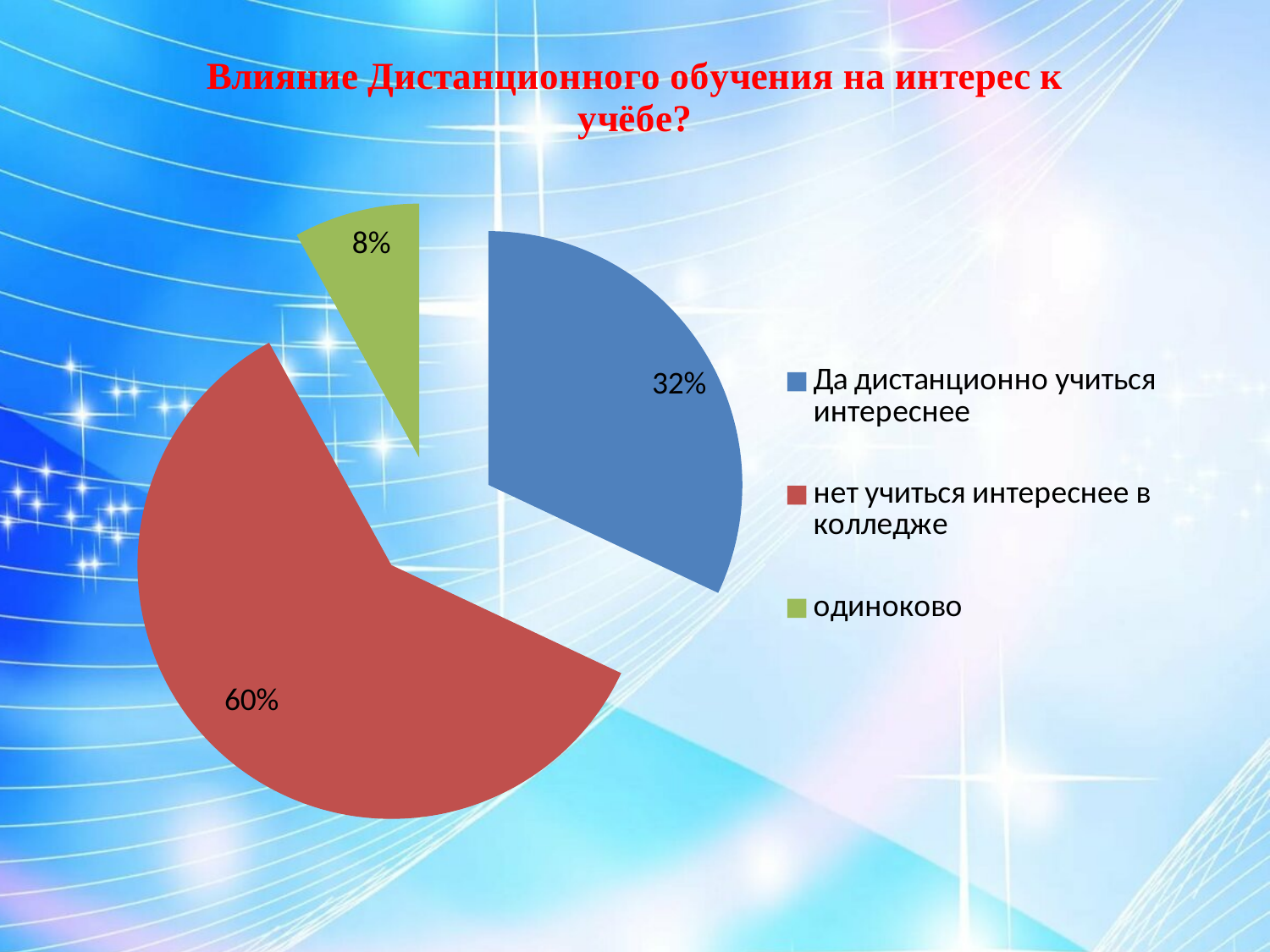
How many entries does the legend list? 3 What kind of chart is shown on the slide? pie chart What is the title of the slide? Влияние Дистанционного обучения на интерес к учёбе? What share of the pie does "одиноково" have? 8% What share of the pie does "Да дистанционно учиться интереснее" have? 32% How many slices does the pie chart have? 3 Which category has the largest slice of the pie? нет учиться интереснее в колледже Which is larger: the share for "Да дистанционно учиться интереснее" or the share for "одиноково"? Да дистанционно учиться интереснее What colour is the slice for "одиноково"? green What share of the pie does "нет учиться интереснее в колледже" have? 60% Which category has the smallest slice of the pie? одиноково What is the difference between the shares for "нет учиться интереснее в колледже" and "Да дистанционно учиться интереснее"? 28%